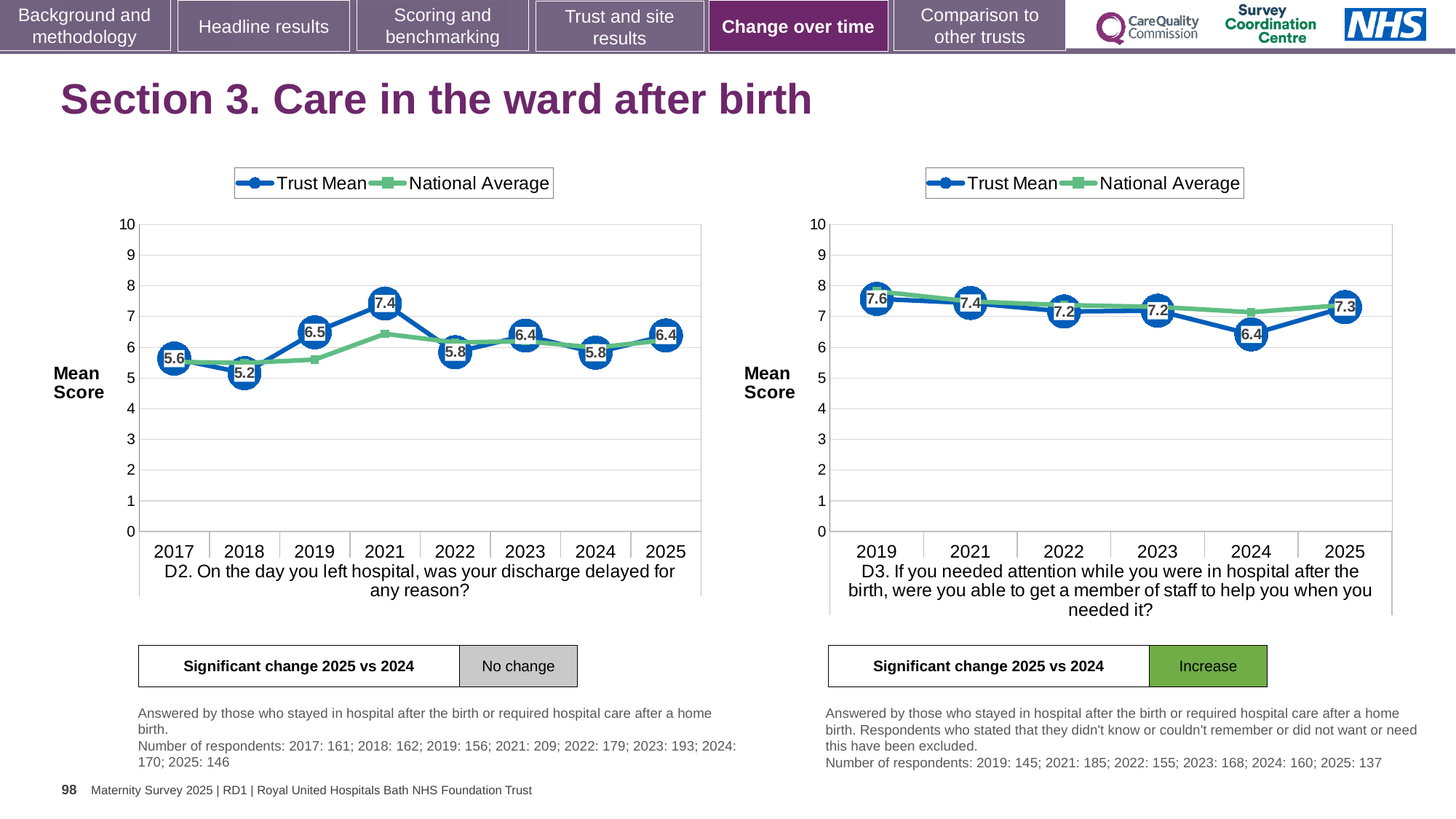
In the D3 chart on the right, what is the difference between the Trust Mean for 2025 and the Trust Mean for 2024? 0.9 How many years are plotted in the D2 chart on the left? 8 How many series does the legend of the D3 chart on the right list? 2 In the D2 chart on the left, is the National Average for 2019 greater or less than 6? less In the D3 chart on the right, which year has the highest Trust Mean? 2019 In the D2 chart on the left, what is the Trust Mean for 2021? 7.4 In the D3 chart on the right, is the National Average for 2019 greater or less than 7? greater What type of chart is the D2 chart on the left? Line chart In the D2 chart on the left, what is the difference between the Trust Mean for 2021 and the Trust Mean for 2018? 2.2 In the D3 chart on the right, what is the Trust Mean for 2024? 6.4 In the D2 chart on the left, is the Trust Mean for 2019 or for 2022 higher? 2019 In the D2 chart on the left, which year has the lowest Trust Mean? 2018